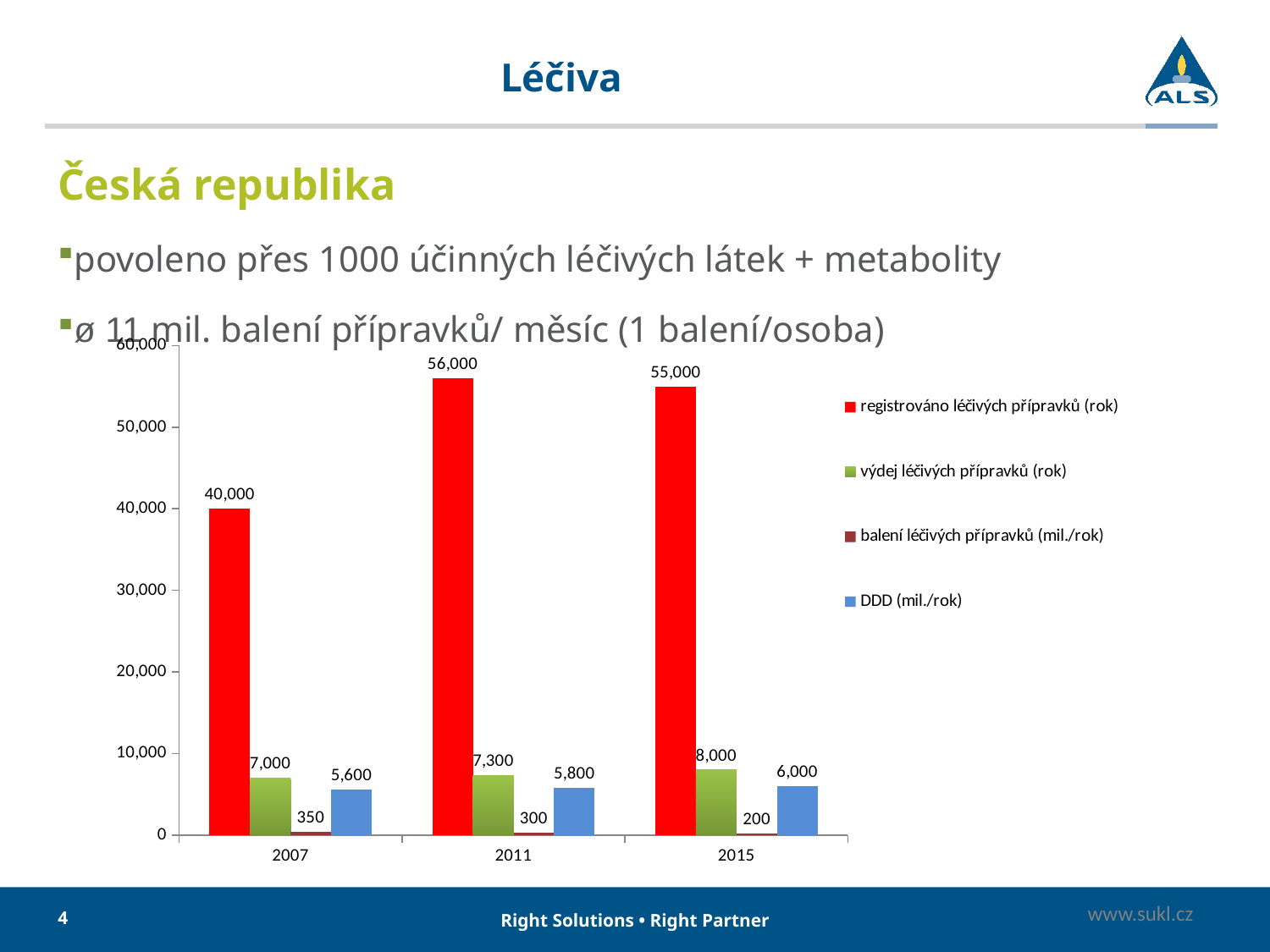
Which is larger: 'DDD (mil./rok)' in 2015 or in 2007? 2015 What is the value of 'DDD (mil./rok)' for 2007? 5,600 In which year is 'balení léčivých přípravků (mil./rok)' the lowest? 2015 What is the difference between 'registrováno léčivých přípravků (rok)' in 2011 and in 2007? 16,000 What kind of chart is shown on the slide? bar chart How many years are shown on the x axis of the chart? 3 What is the value of 'balení léčivých přípravků (mil./rok)' for 2011? 300 What is the value of 'registrováno léčivých přípravků (rok)' for 2011? 56,000 In which year is 'registrováno léčivých přípravků (rok)' the highest? 2011 Is the value for 'registrováno léčivých přípravků (rok)' in 2015 greater or less than 50,000? greater What is the value of 'výdej léčivých přípravků (rok)' for 2015? 8,000 How many series does the chart legend list? 4